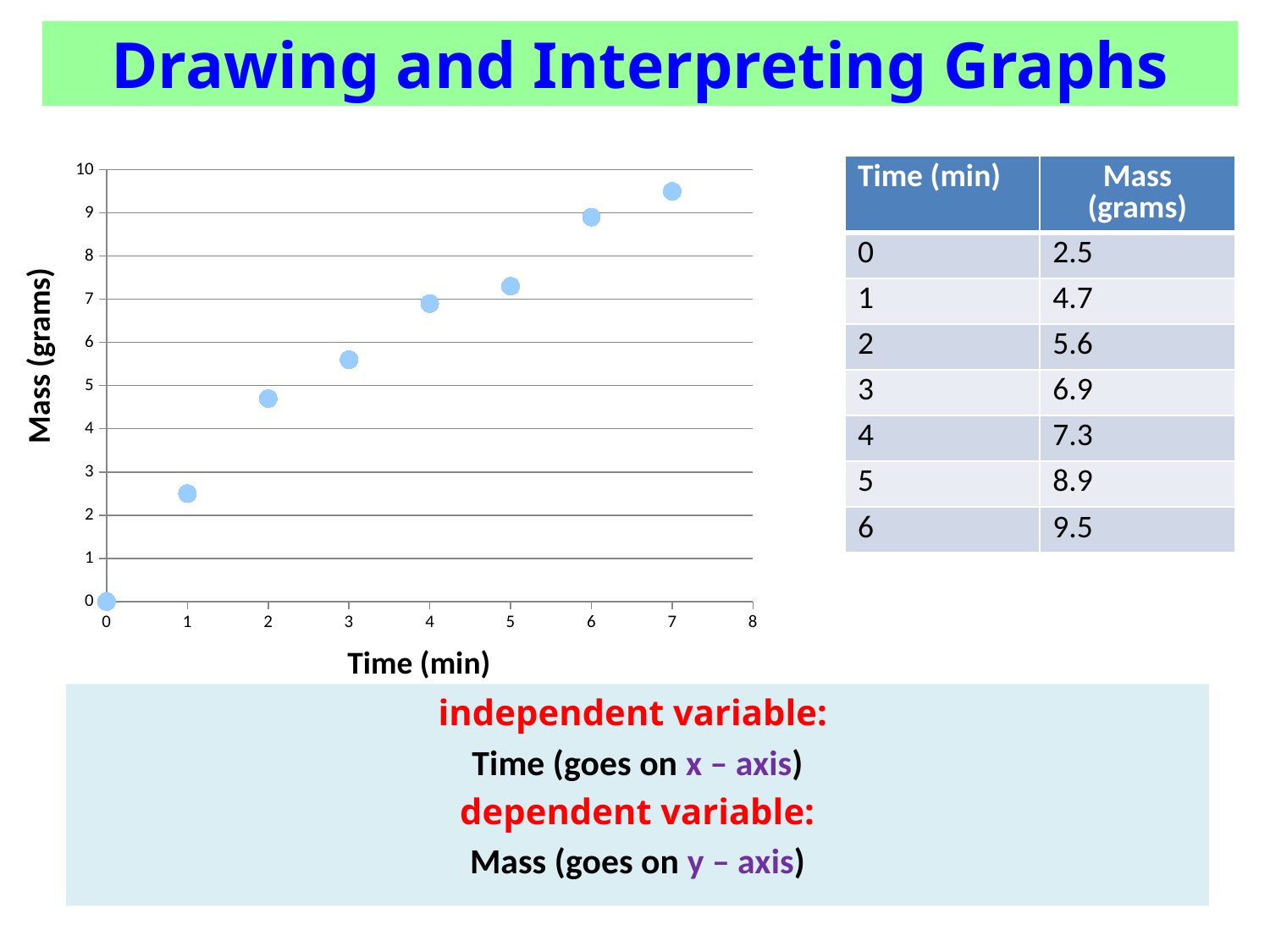
What kind of chart is shown on the slide? scatter chart What is the label on the x axis of the chart? Time (min) Is the plotted mass at time 1 min greater or less than 3 grams? less Which has the larger plotted mass: time 3 min or time 6 min? 6 min At which time (min) on the x axis is the plotted mass highest? 7 Do the plotted mass values rise or fall as time increases along the x axis? rise Is the plotted mass at time 5 min greater or less than 8 grams? less At which time (min) on the x axis is the plotted mass lowest? 0 How many data points are plotted on the chart? 8 Is the plotted mass at time 2 min greater or less than 4 grams? greater What is the label on the y axis of the chart? Mass (grams)